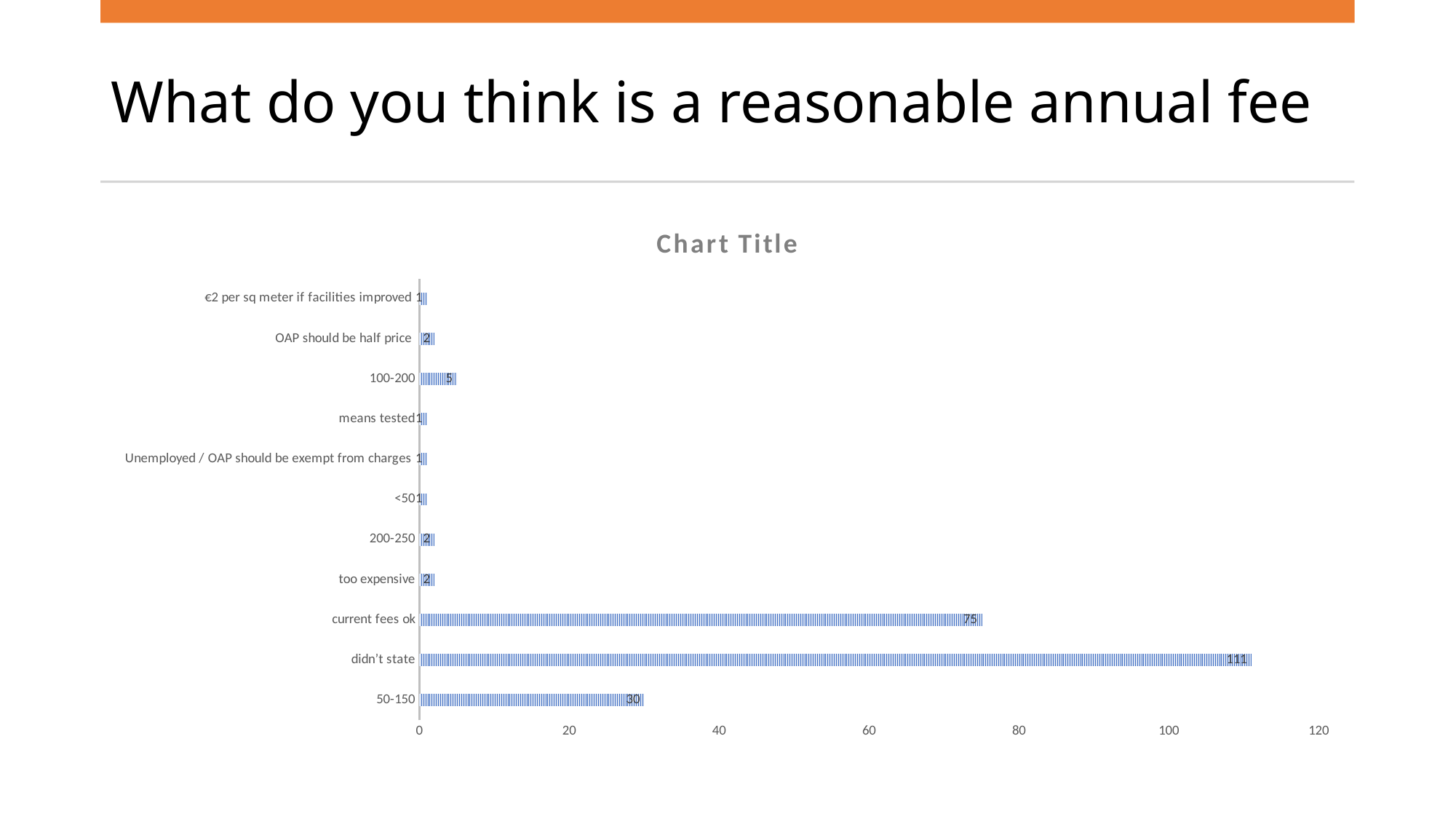
What value is shown for "OAP should be half price"? 2 What value is shown for "50-150"? 30 How many categories are shown in the chart? 11 What is the difference between the values for "current fees ok" and "50-150"? 45 What value is shown for "current fees ok"? 75 Is the value for "didn't state" greater or less than 100? greater What value is shown for "100-200"? 5 Which category has the highest value? didn't state What value is shown for "didn't state"? 111 What is the difference between the values for "didn't state" and "current fees ok"? 36 Which is larger, the value for "50-150" or the value for "100-200"? 50-150 What kind of chart is shown on the slide? bar chart